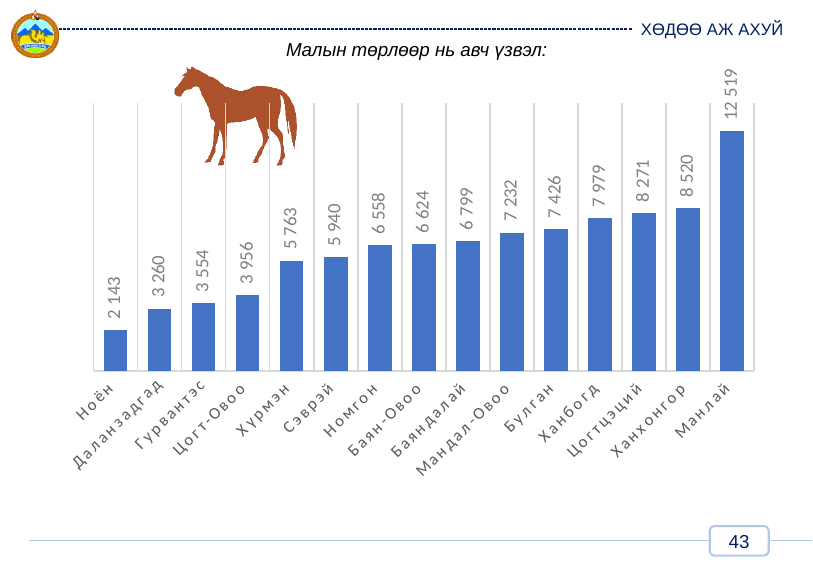
Which is larger, the value for Булган or the value for Хүрмэн? Булган Which category has the lowest value? Ноён What is the difference between the values for Даланзадгад and Ноён? 1 117 Do the values generally rise or fall from left to right along the x axis? Rise Which category has the highest value? Манлай What is the value for Ханхонгор? 8 520 What kind of chart is shown on the slide? Bar chart What is the value for Манлай? 12 519 What is the difference between the values for Манлай and Ханхонгор? 3 999 What is the value for Баяндалай? 6 799 What is the value for Ноён? 2 143 How many categories are shown in the chart? 15